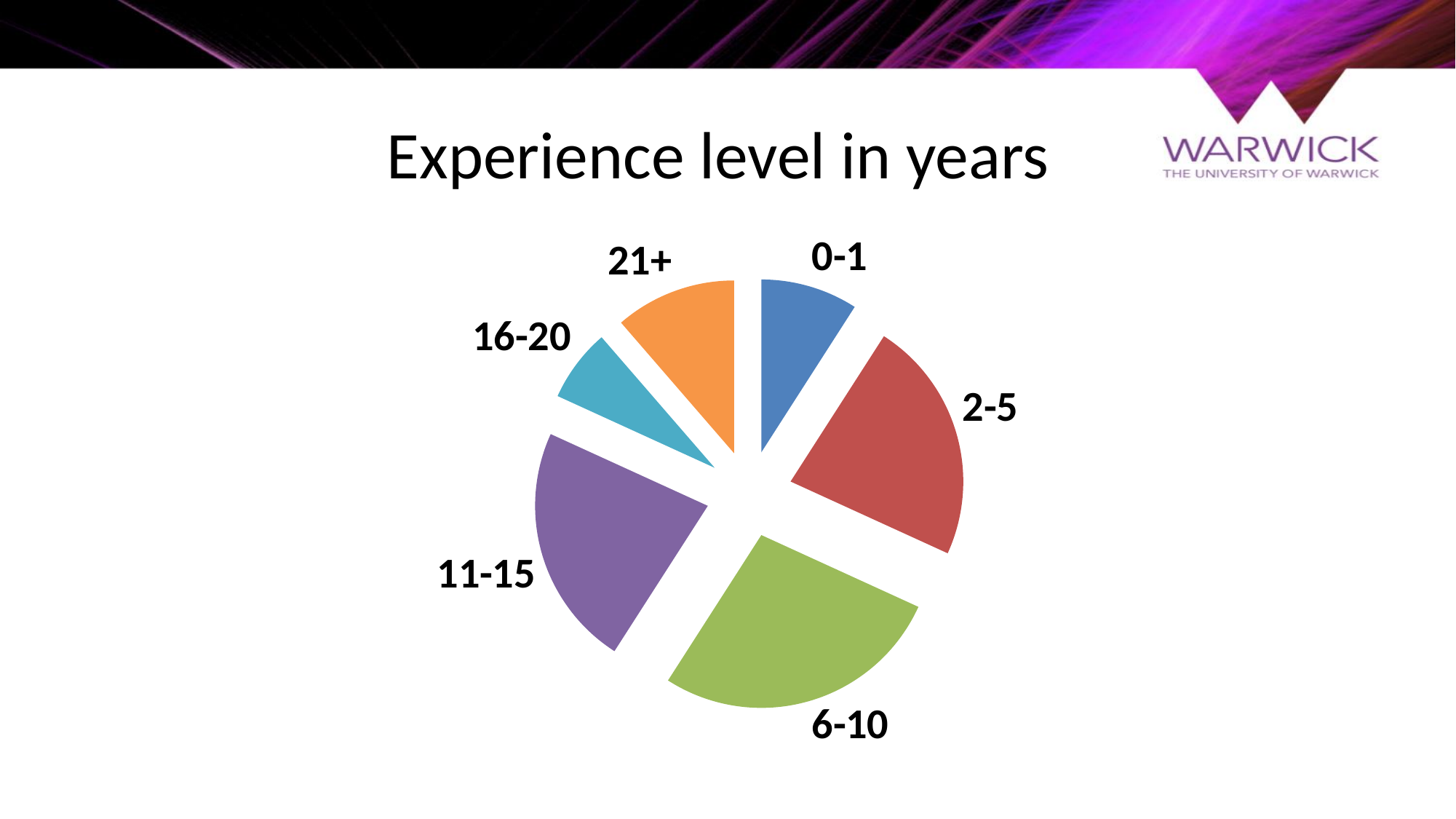
Which slice is larger, 21+ or 16-20? 21+ What colour is the 6-10 slice? green Which slice is larger, 6-10 or 2-5? 6-10 Which slice is larger, 2-5 or 0-1? 2-5 What kind of chart is shown on the slide? pie chart Which experience level has the smallest slice of the pie? 16-20 What is the title of the chart? Experience level in years Which experience level has the largest slice of the pie? 6-10 How many slices does the pie chart have? 6